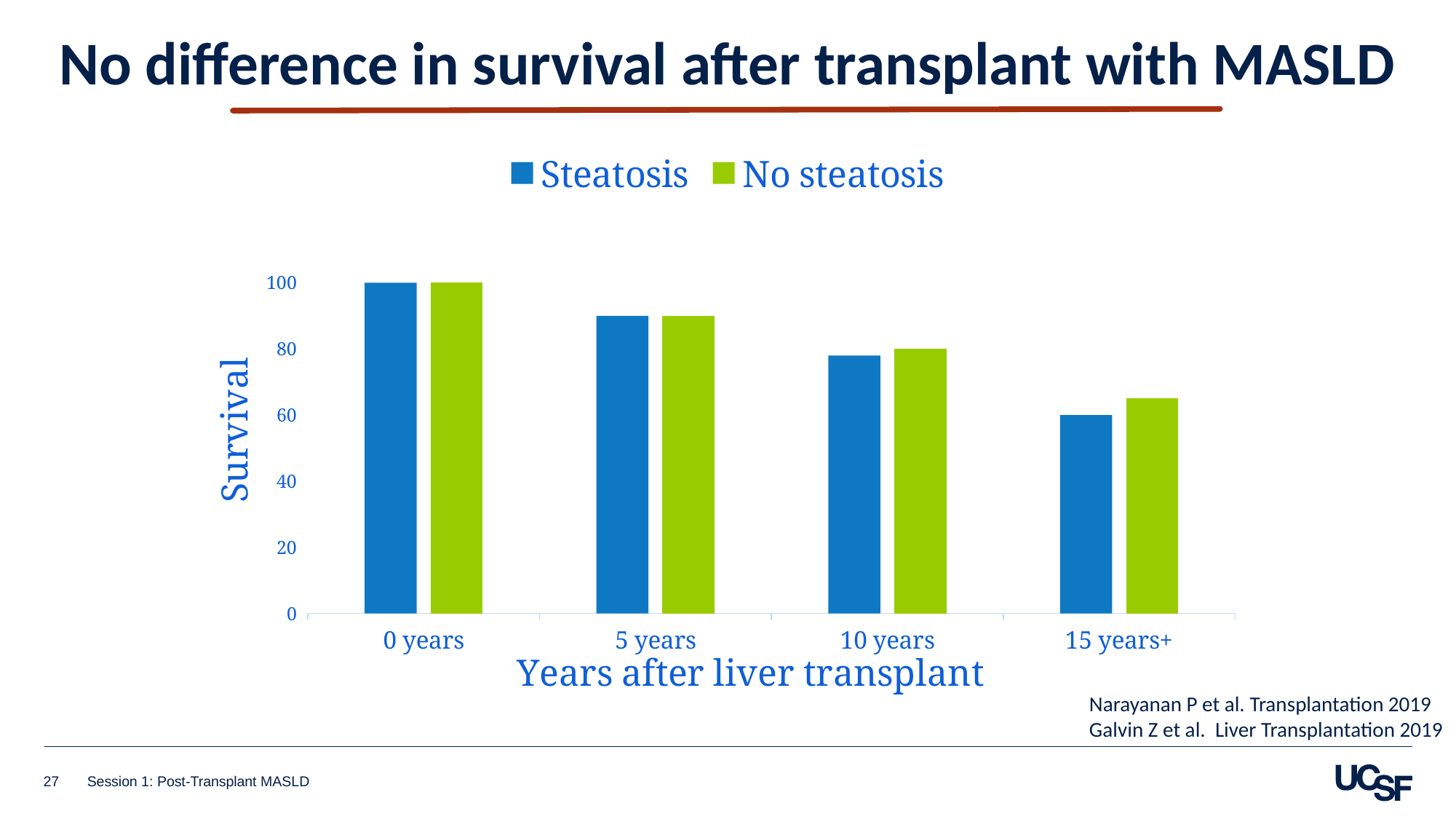
What is the survival value for Steatosis at 15 years+? 60 For the Steatosis series, which category has the lowest value? 15 years+ Is the value for No steatosis at 15 years+ greater or less than 60? greater What kind of chart is shown on the slide? bar chart What is the label of the vertical axis? Survival Is the value for No steatosis at 5 years greater or less than 100? less How many series does the legend list? 2 What is the survival value for Steatosis at 0 years? 100 At 15 years+, which series has the larger value, Steatosis or No steatosis? No steatosis Is the value for Steatosis at 5 years greater or less than 80? greater How many categories are shown on the x axis? 4 Do the survival values rise or fall as years after liver transplant increase? fall